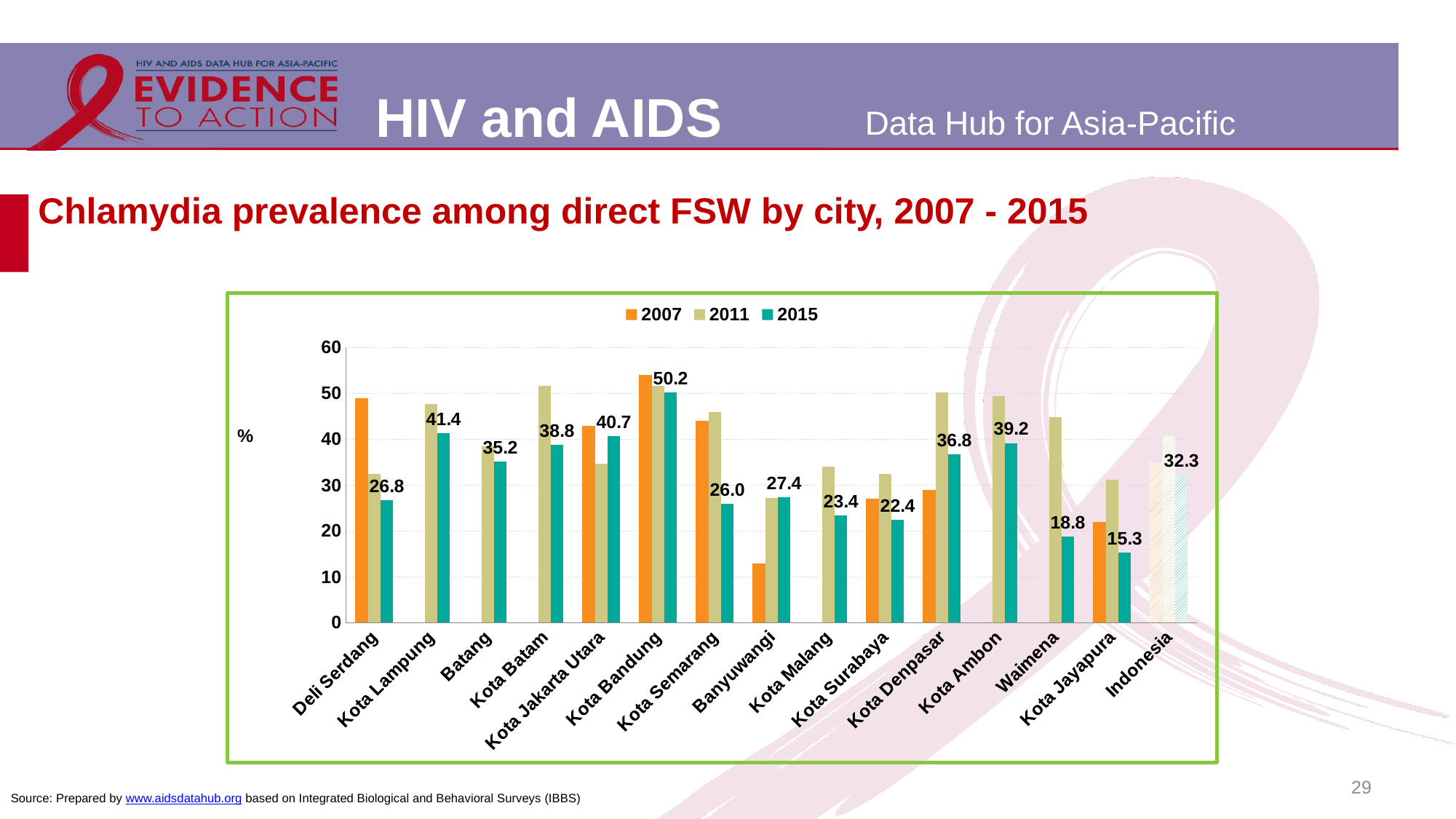
Which series is shown in orange in the legend? 2007 Which city has the lowest 2015 value? Kota Jayapura How many cities/categories are shown on the x axis? 15 What is the 2015 value for Kota Jayapura? 15.3 What is the difference between the 2015 values for Kota Lampung and Deli Serdang? 14.6 How many series does the legend list? 3 Which is larger, the 2015 value for Kota Ambon or for Kota Denpasar? Kota Ambon What is the 2015 value for Indonesia? 32.3 What is the 2015 chlamydia prevalence for Kota Bandung? 50.2 What type of chart is shown on the slide? bar chart Is the 2007 value for Banyuwangi greater or less than 20? less Which city has the highest 2015 value? Kota Bandung